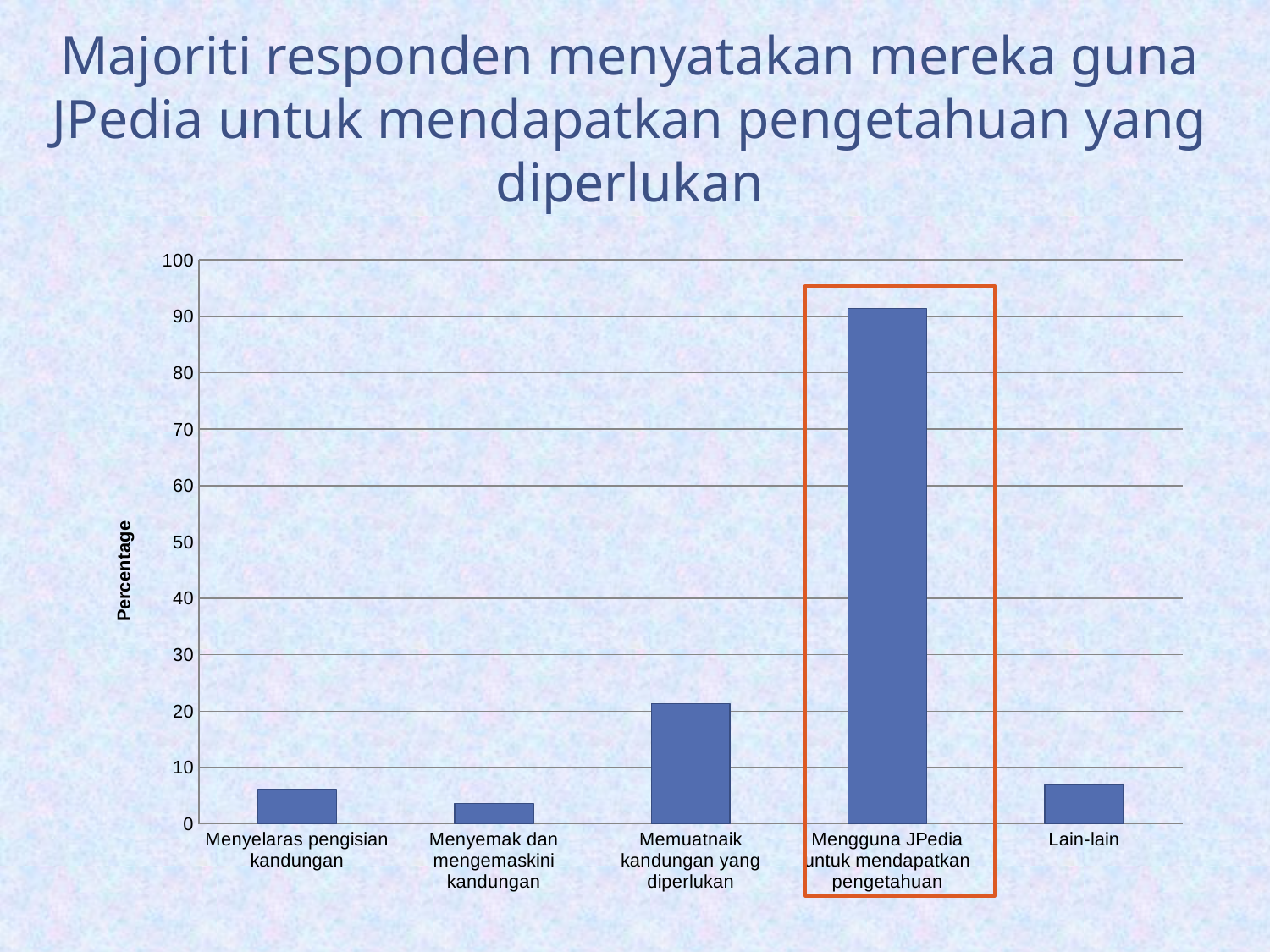
Is the value for Mengguna JPedia untuk mendapatkan pengetahuan greater or less than 90? greater How many categories are shown on the x axis of the chart? 5 Which is larger, the value for Memuatnaik kandungan yang diperlukan or the value for Lain-lain? Memuatnaik kandungan yang diperlukan Is the value for Memuatnaik kandungan yang diperlukan greater or less than 20? greater What kind of chart is shown on the slide? bar chart Which category has the highest value in the chart? Mengguna JPedia untuk mendapatkan pengetahuan Which bar is outlined with an orange box on the chart? Mengguna JPedia untuk mendapatkan pengetahuan Is the value for Menyelaras pengisian kandungan greater or less than 10? less What is the label on the vertical axis of the chart? Percentage Which category has the lowest value in the chart? Menyemak dan mengemaskini kandungan